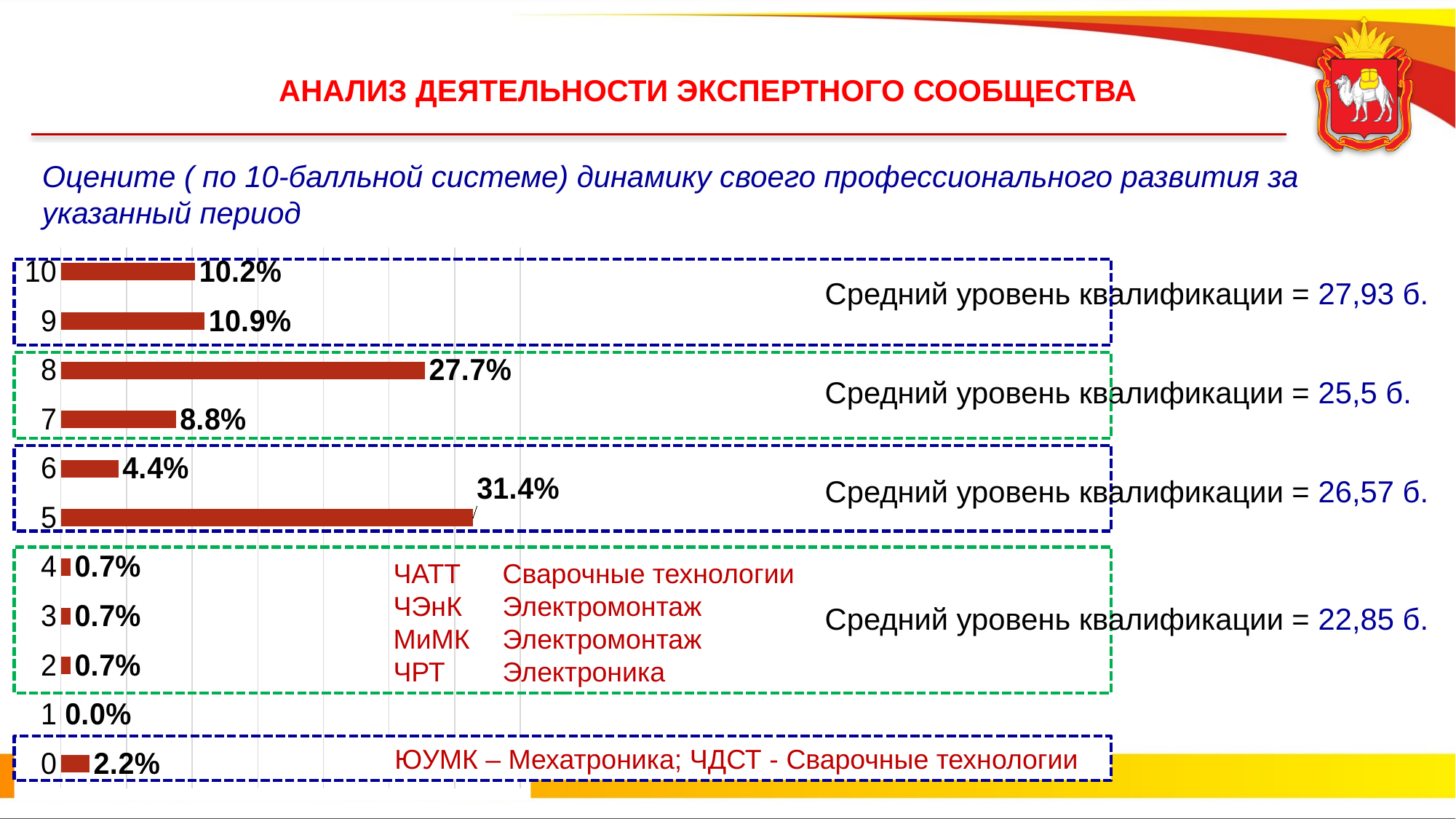
What percentage is shown for score 0 in the bar chart? 2.2% What type of chart is shown on the slide? bar chart What is the difference between the percentages for score 9 and score 10? 0.7% Which score has the lowest percentage in the bar chart? 1 What is the combined percentage for scores 9 and 10? 21.1% Which score has the highest percentage in the bar chart? 5 How many score categories are plotted in the bar chart? 11 What percentage is shown for score 5 in the bar chart? 31.4% Which has a larger percentage, score 7 or score 6? 7 What percentage is shown for score 8 in the bar chart? 27.7% What percentage is shown for score 10 in the bar chart? 10.2% What is the difference between the percentages for score 5 and score 8? 3.7%